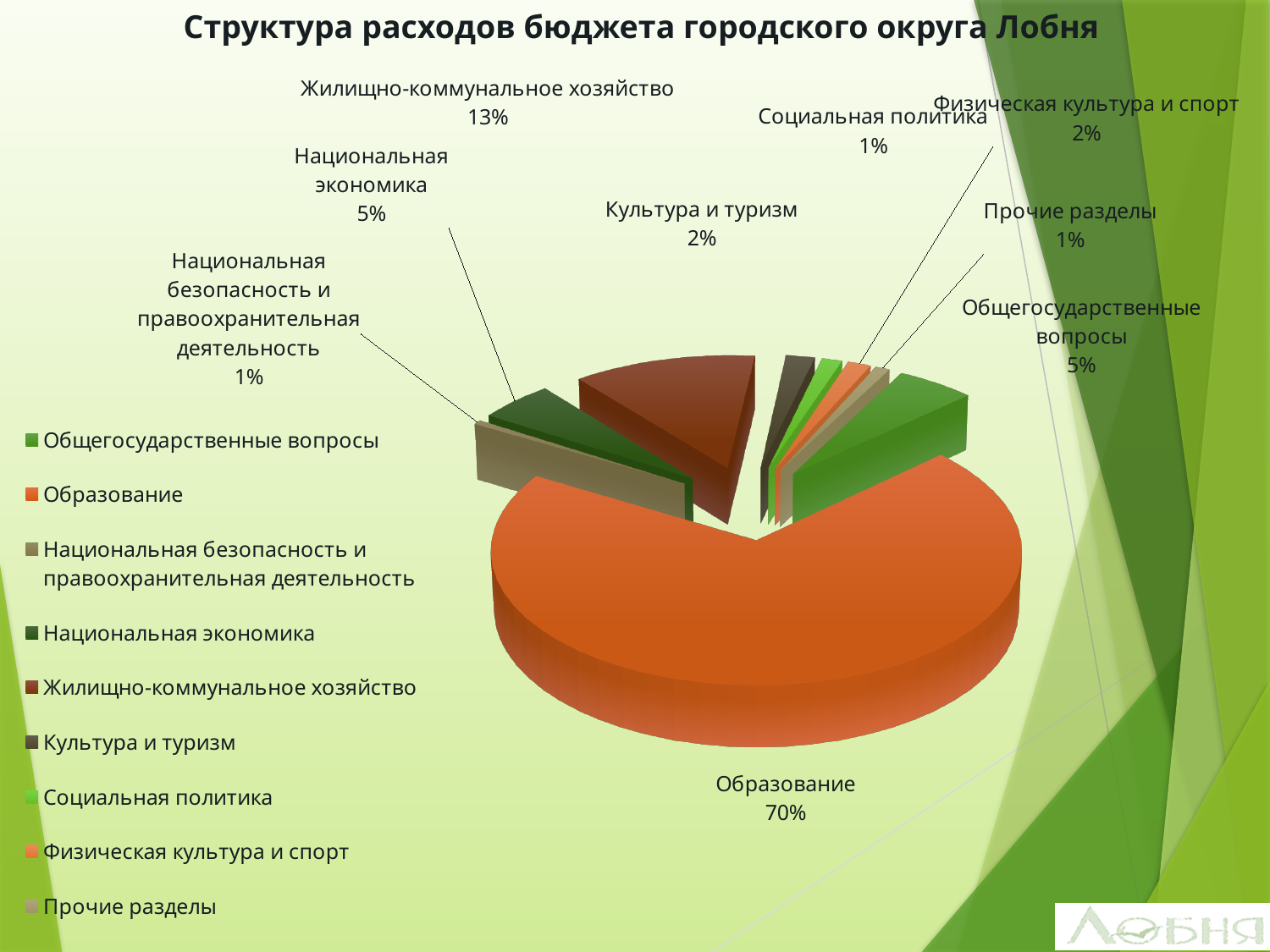
Which is larger: the share for Жилищно-коммунальное хозяйство or the share for Общегосударственные вопросы? Жилищно-коммунальное хозяйство What share of the budget expenditure goes to Образование? 70% What is the difference in percentage points between Образование and Жилищно-коммунальное хозяйство? 57 What percentage is shown for Национальная экономика? 5% Which category has the largest share of the budget expenditure? Образование What percentage is shown for Физическая культура и спорт? 2% What percentage is shown for Жилищно-коммунальное хозяйство? 13% How many categories does the legend list? 9 What percentage is shown for Социальная политика? 1% What type of chart is shown on the slide? Pie chart What is the title of the chart? Структура расходов бюджета городского округа Лобня What is the combined share of Национальная экономика and Общегосударственные вопросы? 10%